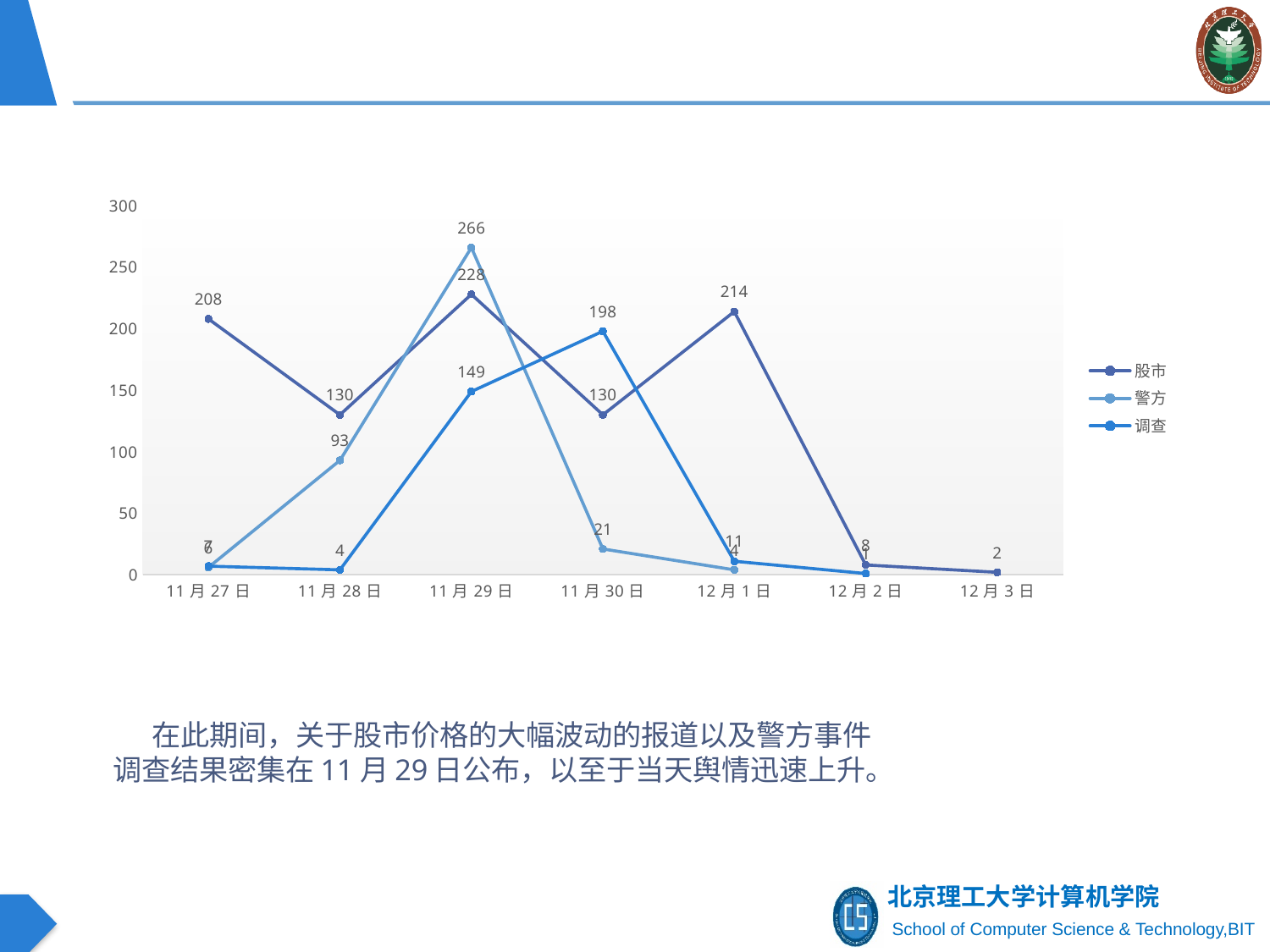
What is the value of 警方 on 11月29日? 266 On which date does 警方 reach its highest value? 11月29日 What kind of chart is shown on the slide? line chart How many series does the legend list? 3 What is the value of 调查 on 11月30日? 198 What is the value of 股市 on 12月1日? 214 On which date does 调查 reach its highest value? 11月30日 What is the value of 股市 on 11月27日? 208 What is the difference between 警方 and 股市 on 11月29日? 38 Which is larger on 11月28日, 股市 or 警方? 股市 How many dates are shown on the x axis? 7 Does the 股市 line rise or fall from 12月1日 to 12月3日? fall